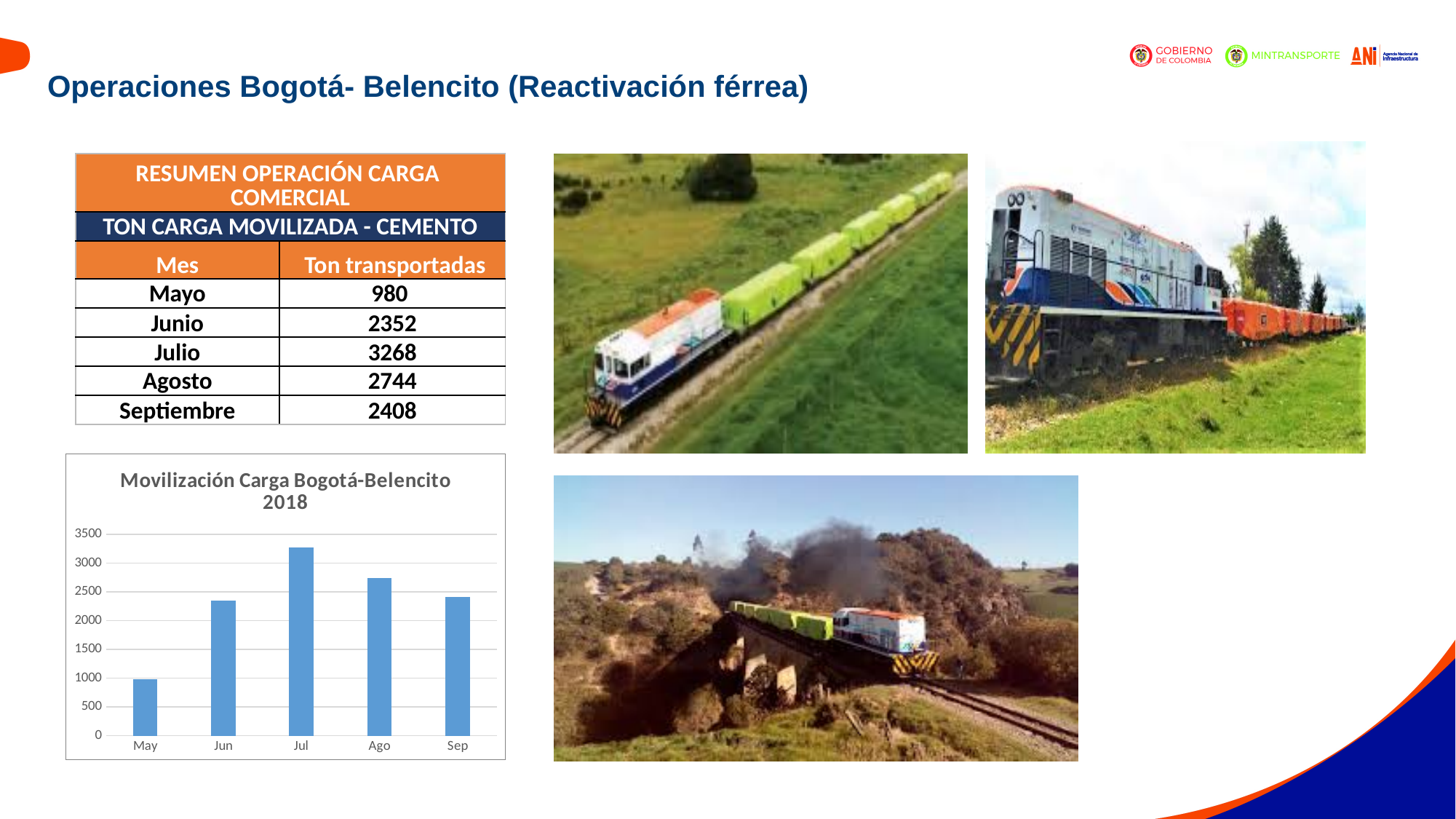
Do the bars rise or fall from May to Jul? rise Which is larger, the bar for Jun or the bar for Ago? Ago Which month has the highest bar in the chart? Jul Is the value for May greater or less than 1500? less How many months are plotted on the chart? 5 What kind of chart is shown on the slide? bar chart According to the table on the slide, what is the difference in tons transported between Julio and Mayo? 2288 Is the value for Sep greater or less than 2000? greater Is the value for Jul greater or less than 3000? greater What is the title of the chart? Movilización Carga Bogotá-Belencito 2018 Which month has the lowest bar in the chart? May According to the table on the slide, how many tons were transported in Julio? 3268